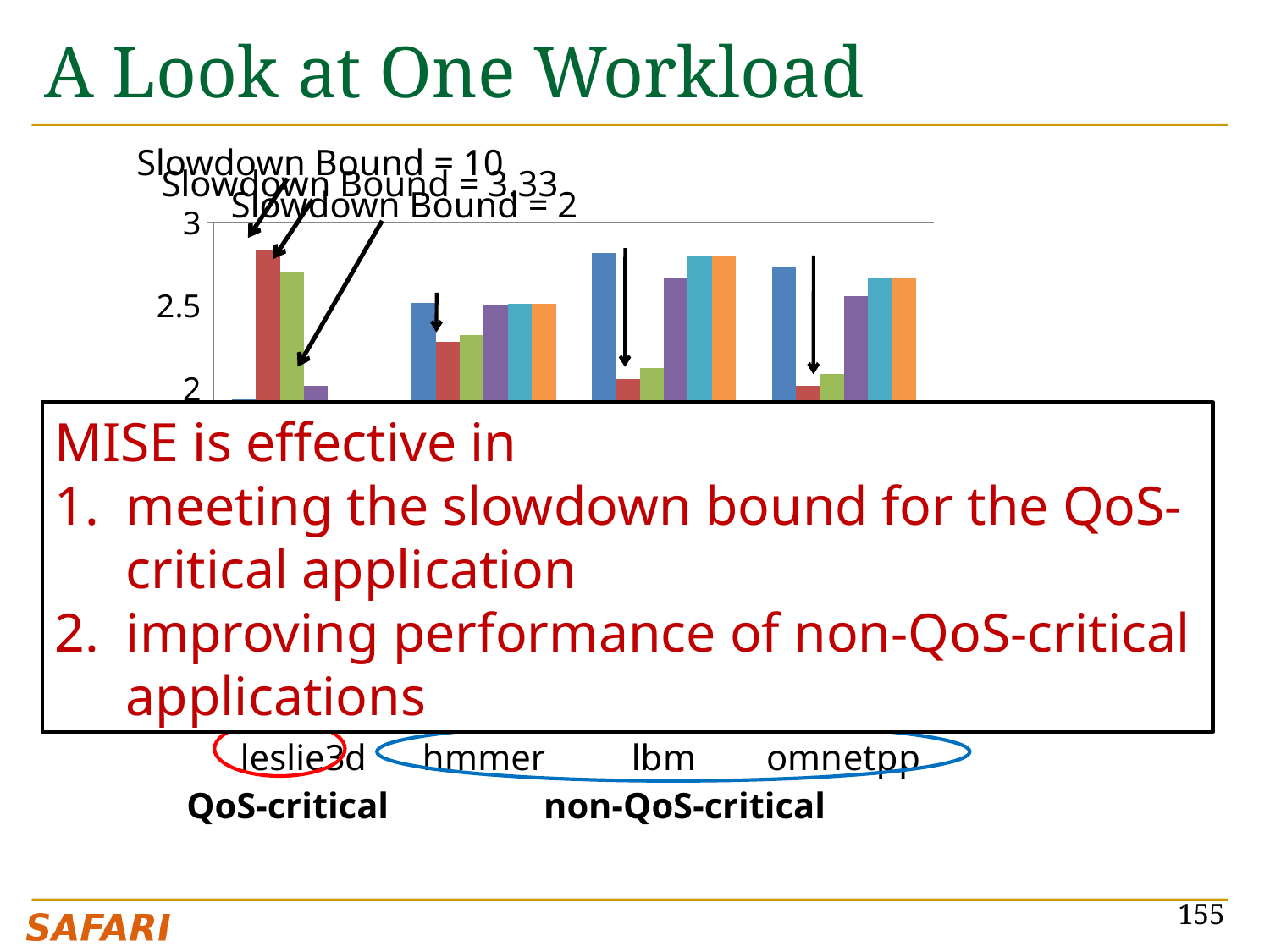
What kind of chart is shown on the slide? bar chart How many applications (categories) are shown along the x axis of the chart? 4 Is the red bar for leslie3d greater or less than 2.5? greater Is the orange bar for omnetpp greater or less than 2.5? greater What three slowdown bound values are annotated above the chart? 10, 3.33 and 2 How many applications are grouped under the non-QoS-critical label? 3 Is the tallest bar for lbm greater or less than 2.5? greater For lbm, which is taller: the blue bar or the red bar? the blue bar Which application on the x axis is labelled as QoS-critical? leslie3d